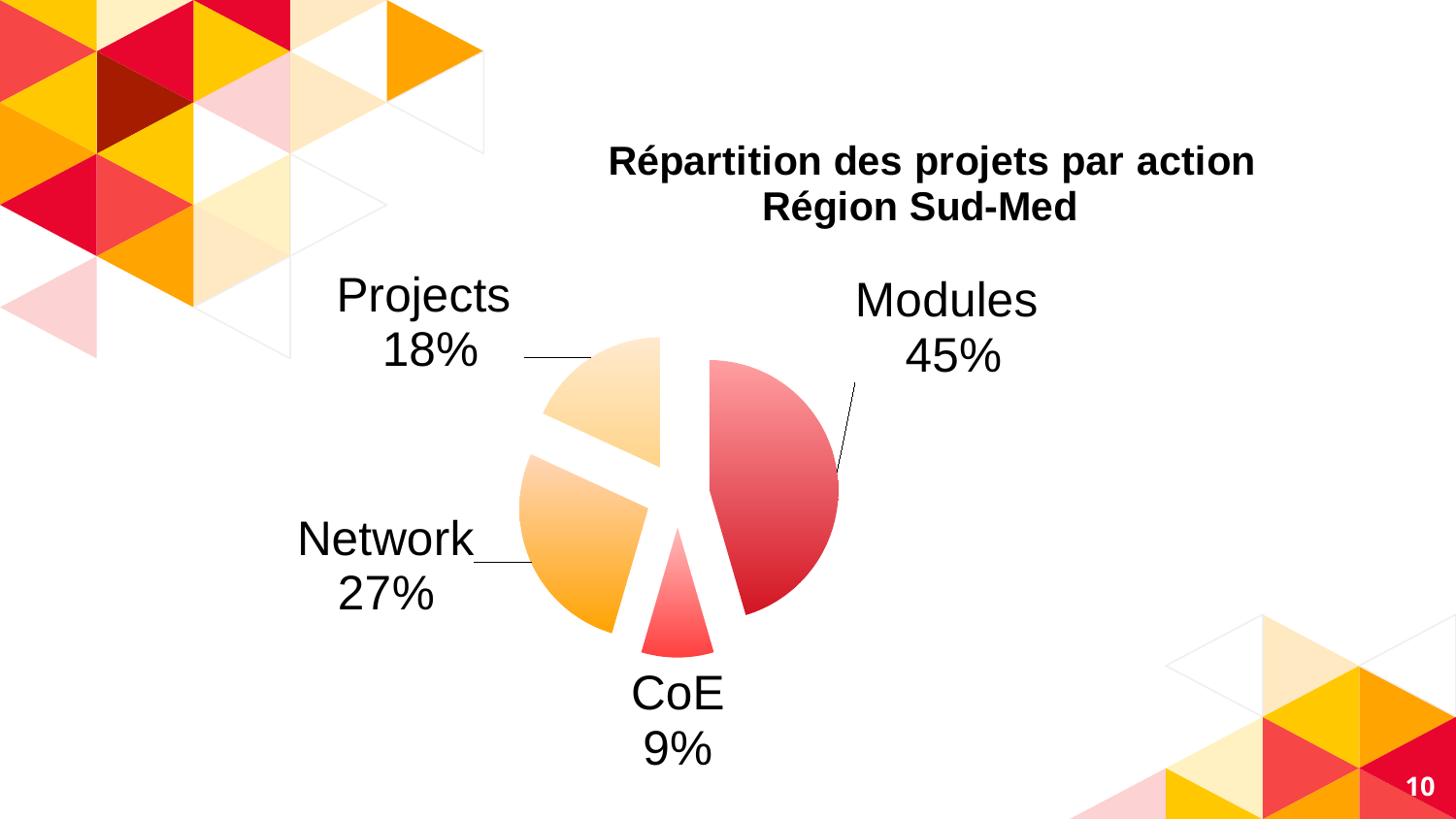
What is the difference in percentage points between Modules and Network? 18 What share of the pie does Modules represent? 45% What percentage is shown for CoE? 9% What percentage is shown for Network? 27% How many categories are shown in the pie chart? 4 What kind of chart is shown on the slide? Pie chart What is the title of the chart? Répartition des projets par action Région Sud-Med What is the difference in percentage points between Projects and CoE? 9 Which category has the largest share of the pie? Modules Which category has the smallest share of the pie? CoE What percentage is shown for Projects? 18% Which is larger, the share for Network or the share for Projects? Network